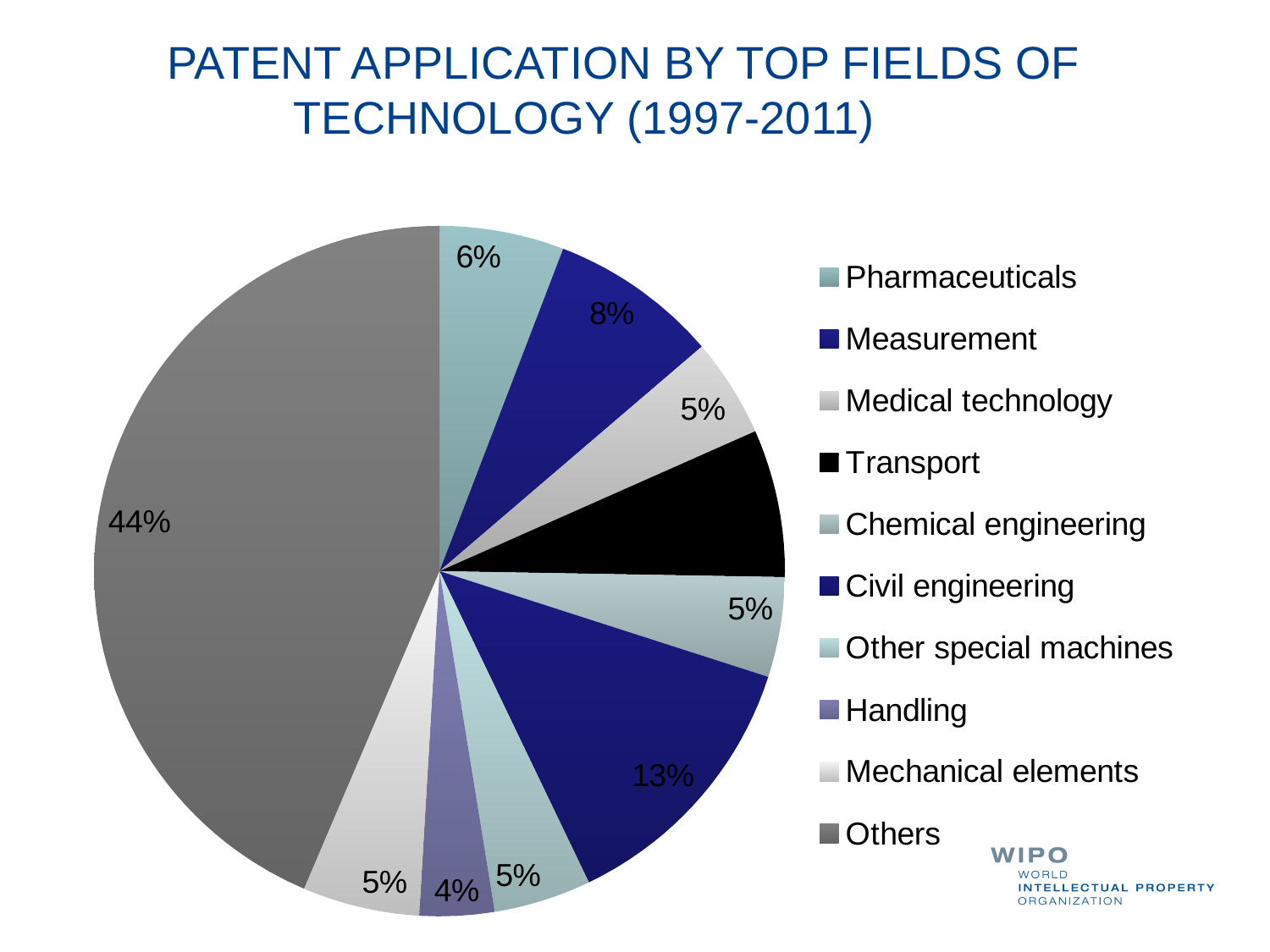
What percentage is shown for Pharmaceuticals? 6% How many percentage points larger is the Others slice than the Civil engineering slice? 31% What percentage is shown for Measurement? 8% How many percentage points larger is Measurement than Pharmaceuticals? 2% What kind of chart is shown on the slide? Pie chart Which is larger, the share for Civil engineering or the share for Measurement? Civil engineering What percentage is shown for Civil engineering? 13% What colour is the Transport slice? Black What share of the pie does Others account for? 44% How many fields of technology are listed in the legend? 10 Which field has the largest slice of the pie? Others What percentage is shown for Handling? 4%